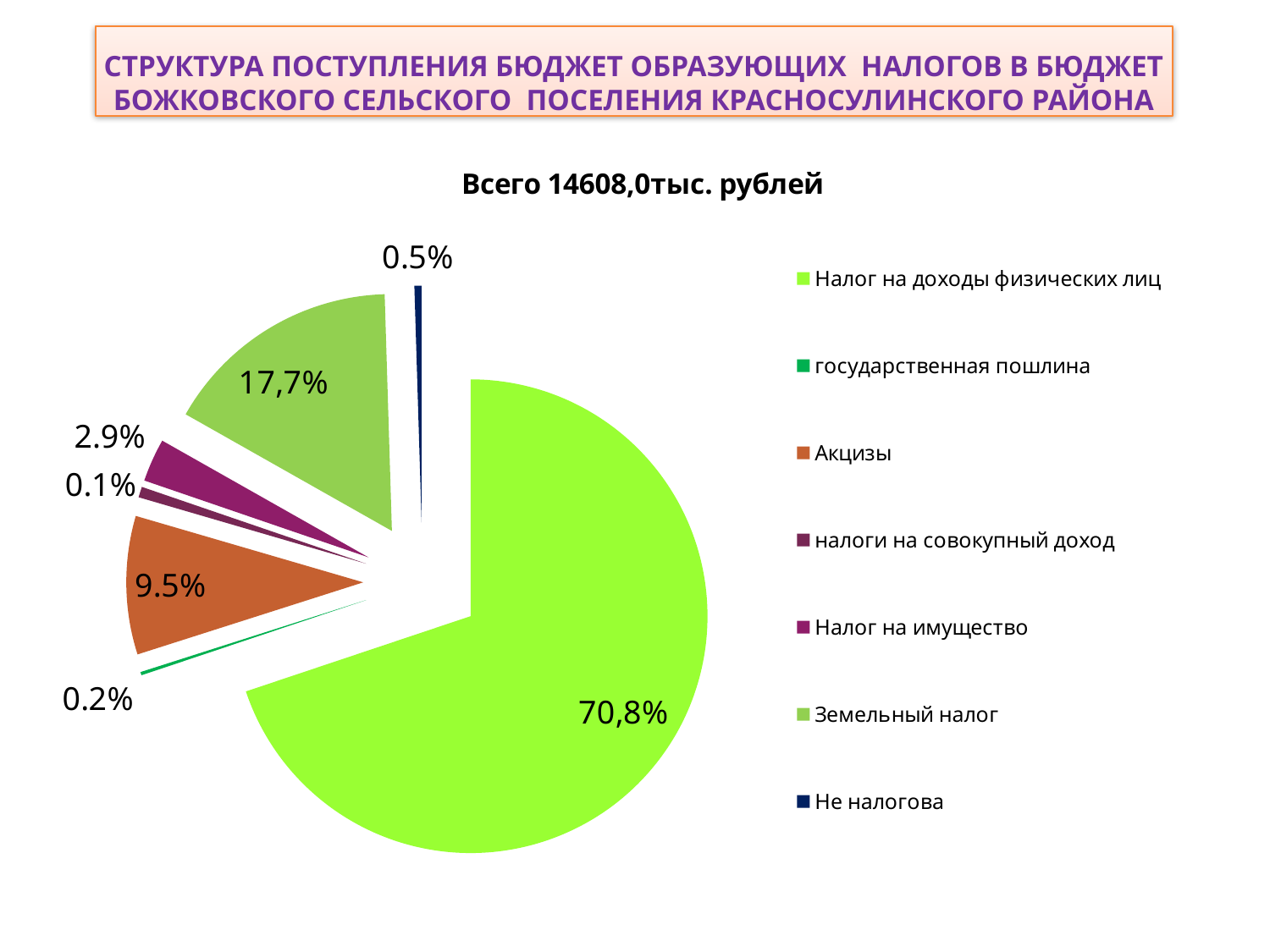
Which category has the largest slice of the pie? Налог на доходы физических лиц What share of the pie is государственная пошлина? 0.2% How many entries does the chart legend list? 7 What share of the pie is Акцизы? 9.5% What share of the pie is Налог на имущество? 2.9% What is the title of the chart? Всего 14608,0тыс. рублей What kind of chart is shown on the slide? pie chart Which is larger, the slice for Земельный налог or the slice for Акцизы? Земельный налог